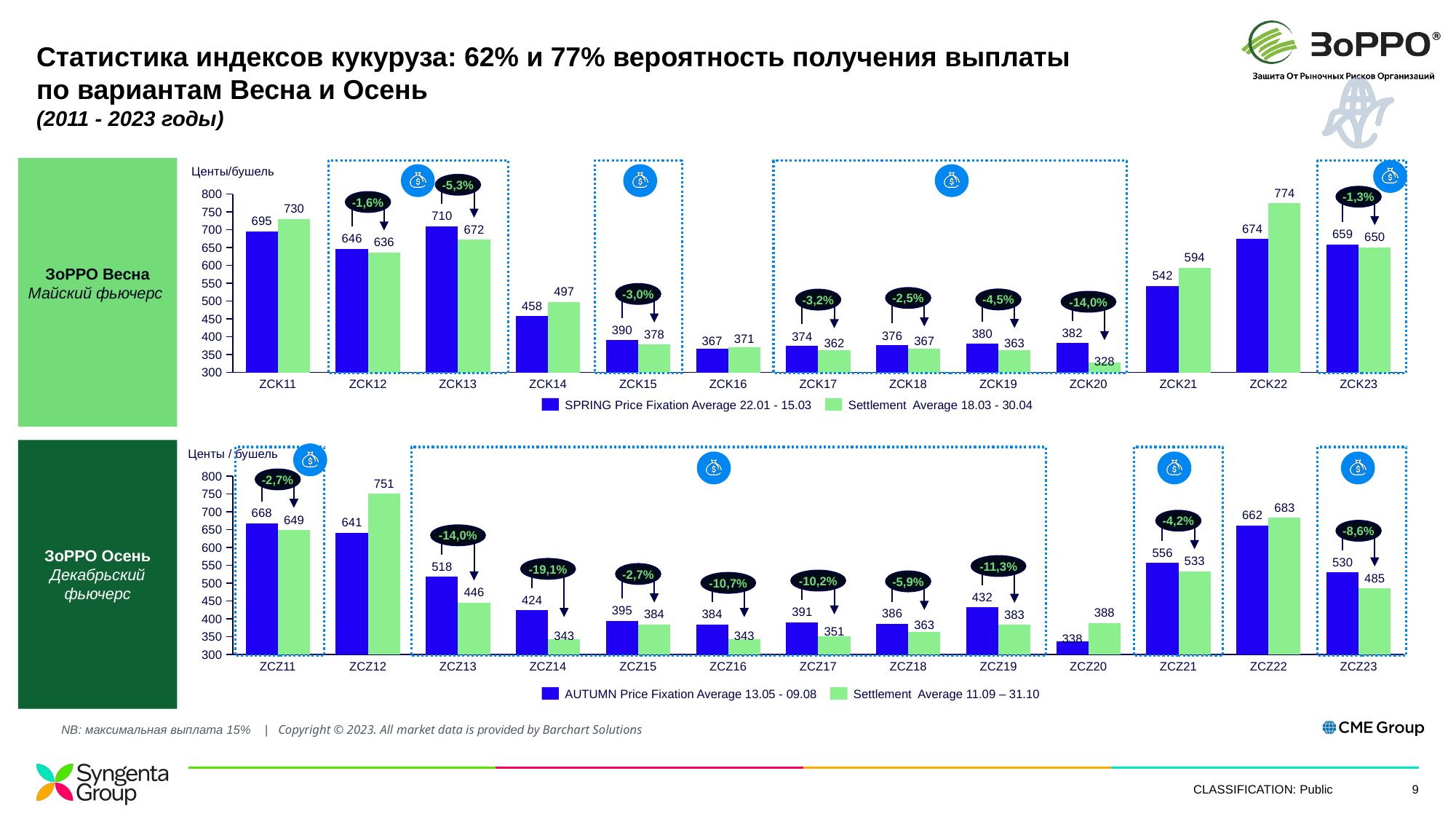
In the bottom chart (ЗоРРО Осень), what is the AUTUMN Price Fixation Average value for ZCZ13? 518 In the bottom chart (ЗоРРО Осень), which is larger for ZCZ14: the AUTUMN Price Fixation Average or the Settlement Average? AUTUMN Price Fixation Average In the bottom chart (ЗоРРО Осень), what is the difference between the AUTUMN Price Fixation Average and the Settlement Average for ZCZ19? 49 In the bottom chart (ЗоРРО Осень), what is the Settlement Average value for ZCZ23? 485 How many series does the legend of the bottom chart (ЗоРРО Осень) list? 2 In the top chart (ЗоРРО Весна), what is the difference between the SPRING Price Fixation Average and the Settlement Average for ZCK20? 54 In the bottom chart (ЗоРРО Осень), which category has the highest Settlement Average value? ZCZ12 In the top chart (ЗоРРО Весна), what is the SPRING Price Fixation Average value for ZCK11? 695 In the top chart (ЗоРРО Весна), how many categories are shown on the x axis? 13 In the top chart (ЗоРРО Весна), which category has the lowest Settlement Average value? ZCK20 In the top chart (ЗоРРО Весна), what is the Settlement Average value for ZCK22? 774 What type of chart is the top chart (ЗоРРО Весна)? Bar chart